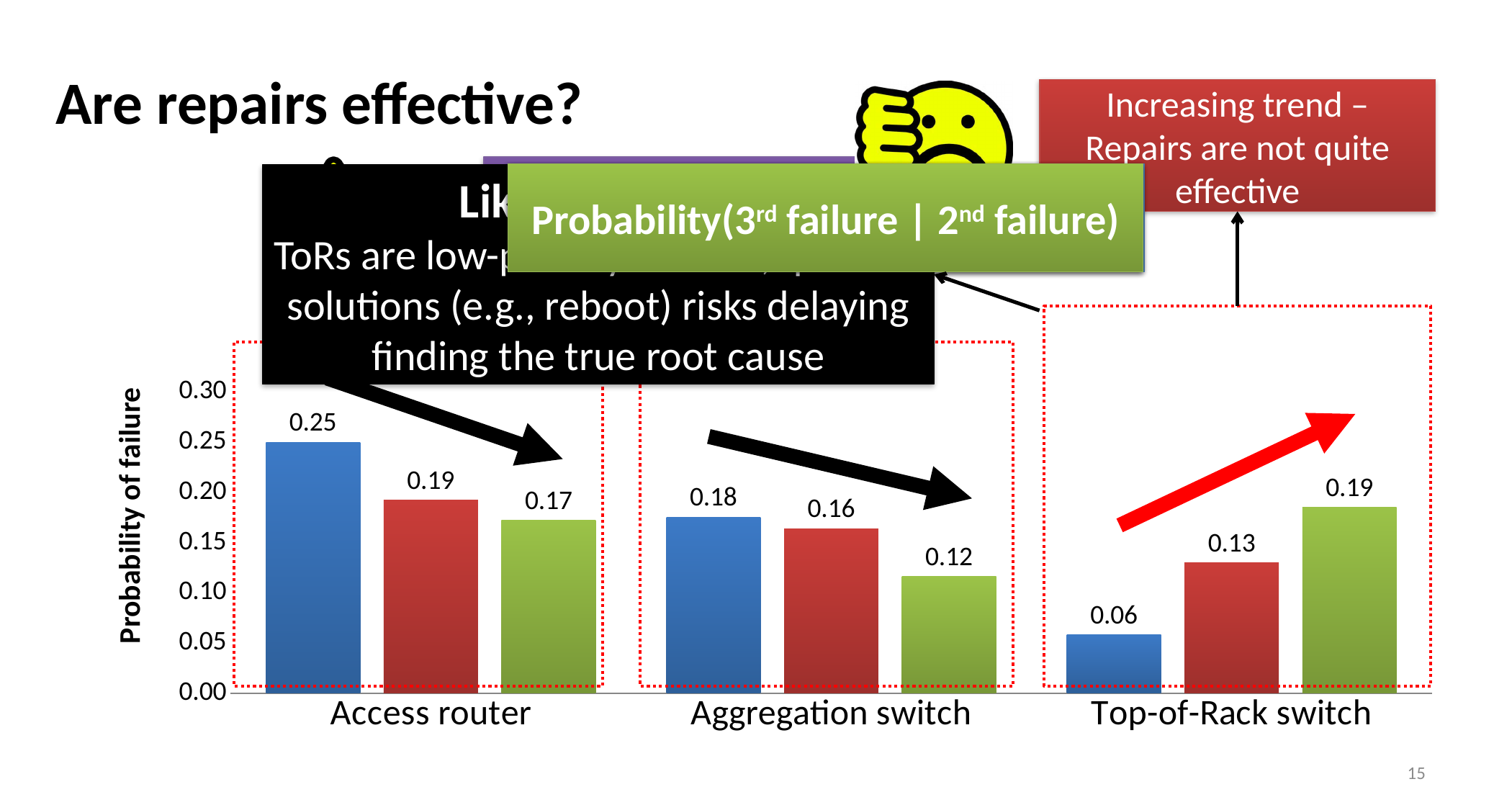
What kind of chart is shown on the slide? bar chart What is the difference between the green bar and the blue bar for Top-of-Rack switch? 0.13 Which is larger: the green bar for Access router or the green bar for Top-of-Rack switch? Top-of-Rack switch What is the difference between the blue bar and the green bar for Access router? 0.08 Is the value of the blue bar for Aggregation switch greater or less than 0.15? greater Which category has the highest blue bar? Access router What is the value of the green bar (Probability(3rd failure | 2nd failure)) for Top-of-Rack switch? 0.19 Do the bars for Top-of-Rack switch rise or fall from the blue bar to the green bar? rise How many categories are shown on the x axis? 3 Which category has the lowest bar in the whole chart? Top-of-Rack switch What is the value of the blue bar for Access router? 0.25 What is the value of the red bar for Aggregation switch? 0.16